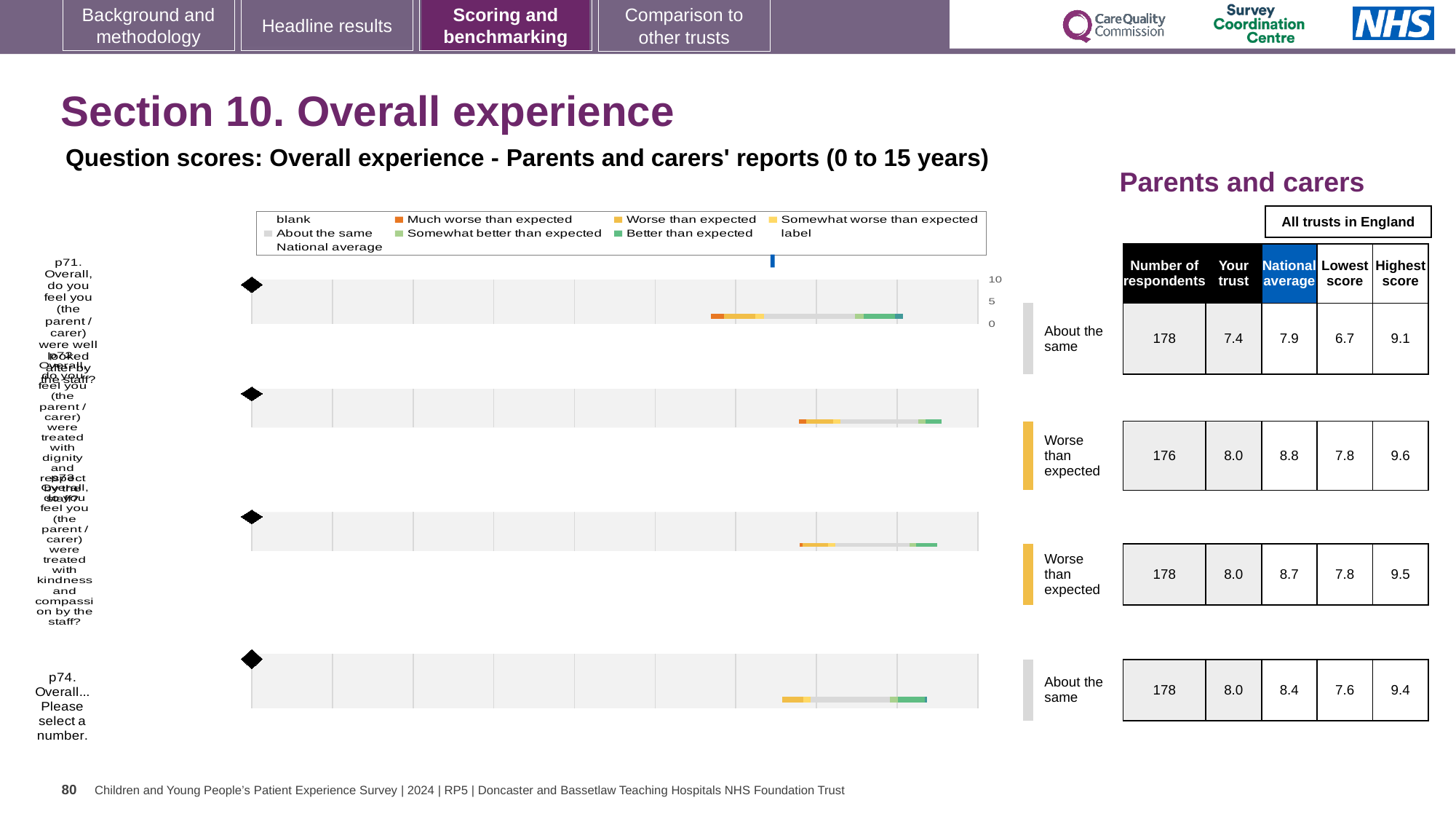
What is the 'Your trust' score for p71 (Overall, do you feel you were well looked after by the staff?)? 7.4 Which is larger for p74: the 'Your trust' score or the national average? National average What benchmark category is shown for p74 (Overall... Please select a number)? About the same What is the difference between the national average and the 'Your trust' score for p72? 0.8 What is the national average score for p72 (treated with dignity and respect)? 8.8 How many entries does the chart legend list? 9 Which question has the lowest 'Your trust' score? p71 What kind of chart is used to show the question scores on this slide? bar chart Which legend entry is shown in orange? Much worse than expected What is the highest score for p73 (treated with kindness and compassion by the staff)? 9.5 How many question rows (bars) are plotted in the chart? 4 How many respondents answered p72? 176